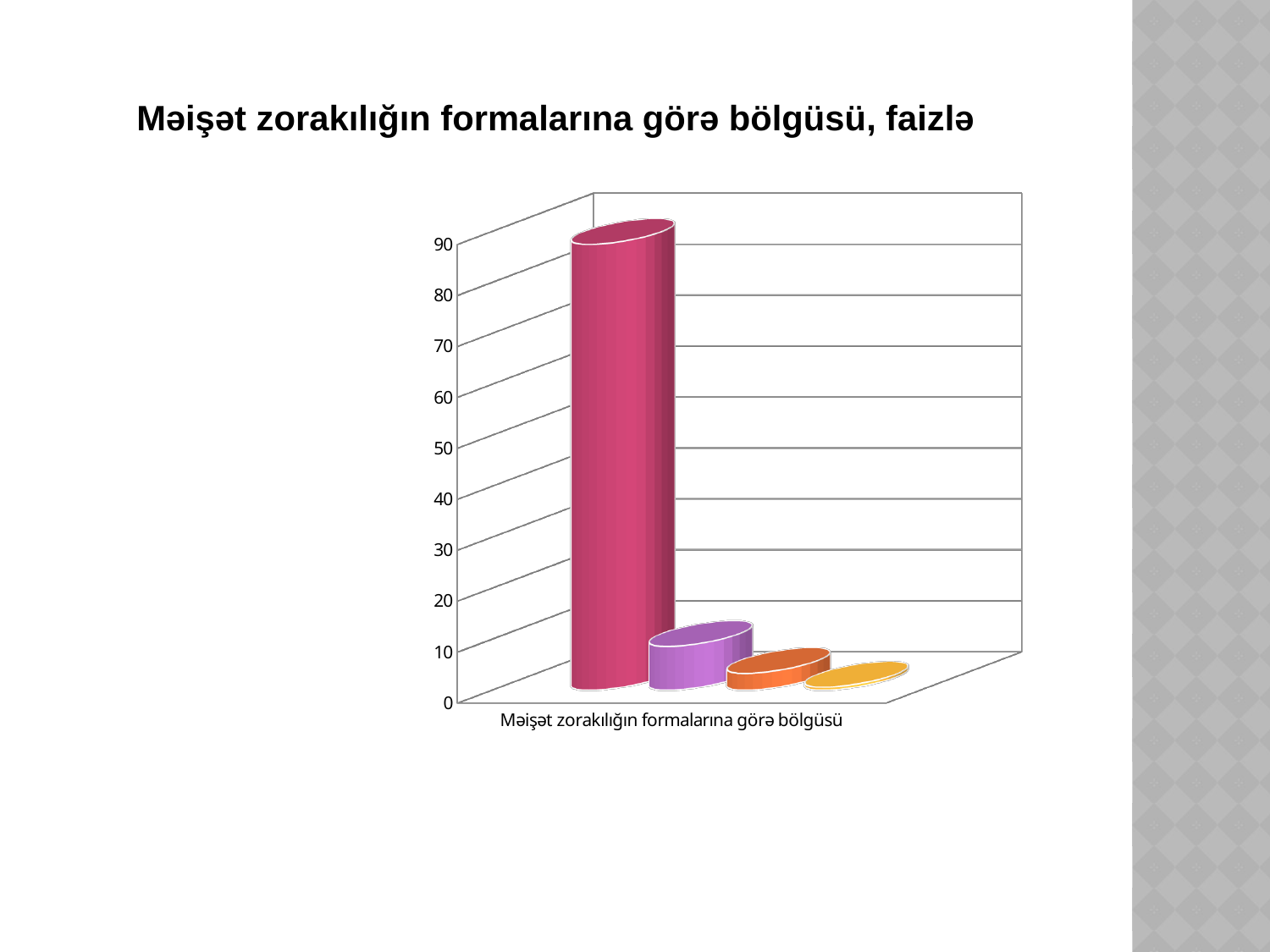
Do the bar values rise or fall from left to right across the chart? fall Which bar is the tallest in the chart? the pink bar (first from the left) How many bars are plotted in the chart? 4 What kind of chart is shown on the slide? bar chart Which bar is the shortest in the chart? the yellow bar (last on the right) What is the highest value shown on the vertical axis of the chart? 90 What is the title of the slide above the chart? Məişət zorakılığın formalarına görə bölgüsü, faizlə Which is larger, the orange bar or the yellow bar? the orange bar Is the value of the pink bar greater or less than 70? greater Is the value of the purple bar greater or less than 20? less Which is larger, the pink bar or the purple bar? the pink bar Is the value of the yellow bar greater or less than 10? less